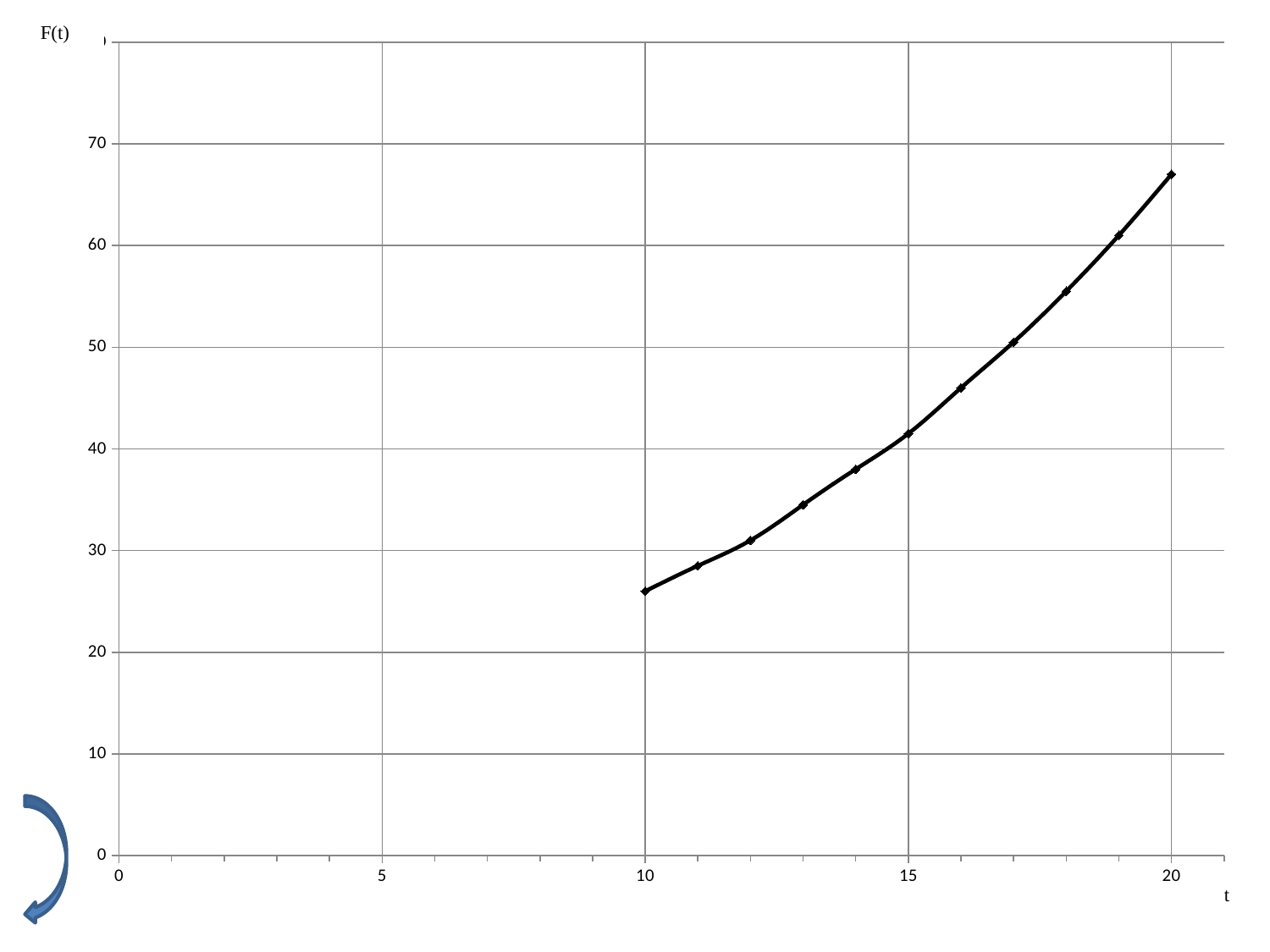
Is the value of F(t) at t = 20 greater or less than 60? greater What kind of chart is shown on the slide? line chart At which value of t is F(t) highest? 20 What is the label on the vertical axis? F(t) At which value of t is F(t) lowest? 10 Is the value of F(t) at t = 16 greater or less than 50? less Is the value of F(t) at t = 18 greater or less than 50? greater What is the label on the horizontal axis? t Do the values of F(t) rise or fall as t increases from 10 to 20? rise Which is larger, F(t) at t = 14 or F(t) at t = 19? t = 19 How many data points are plotted on the line? 11